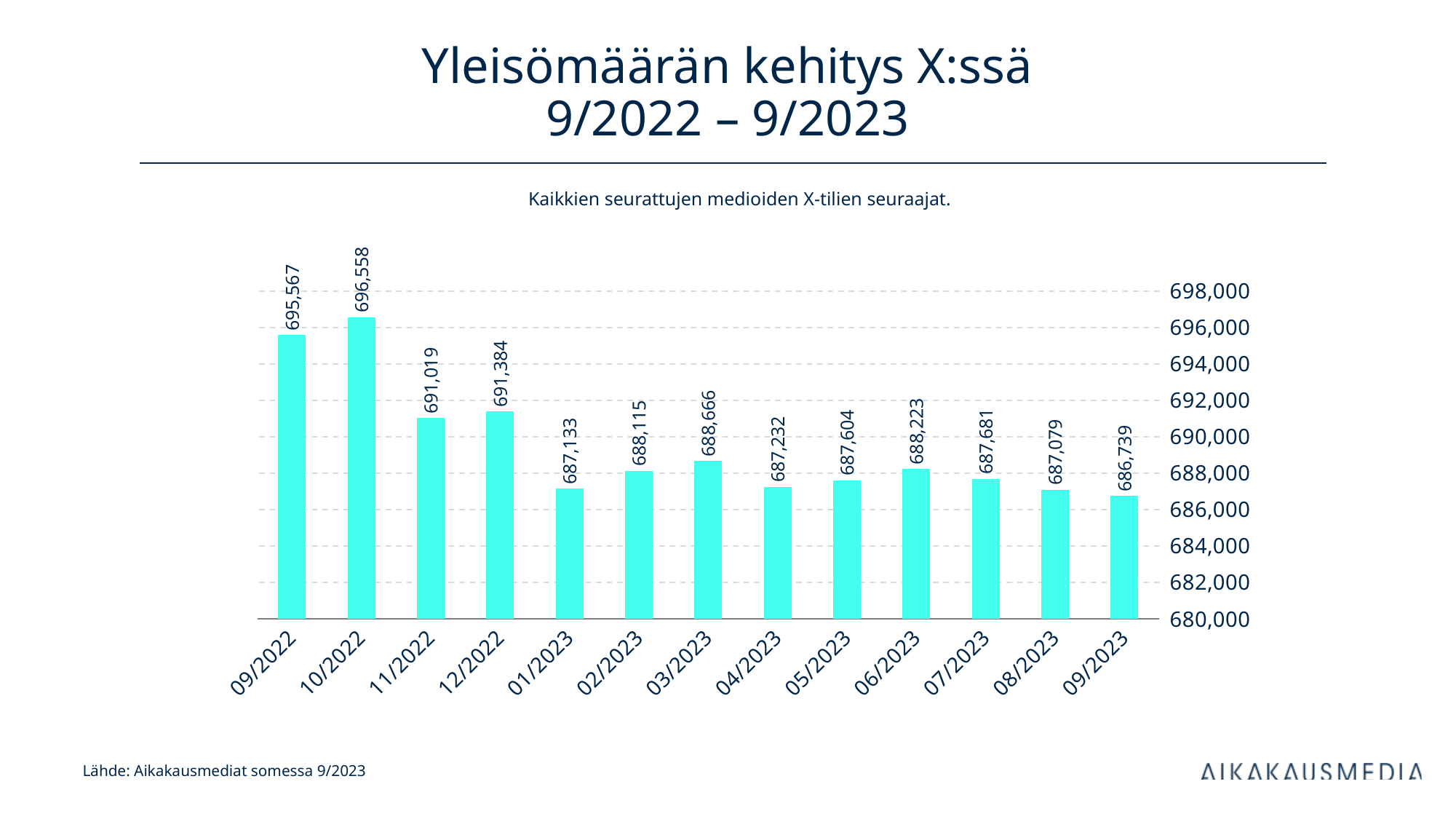
Which month has the highest value? 10/2022 Is the value for 11/2022 greater or less than 690,000? greater What kind of chart is shown on the slide? bar chart What is the value for 09/2023? 686,739 What is the value for 10/2022? 696,558 What is the value for 03/2023? 688,666 Do the values generally rise or fall from 09/2022 to 09/2023? fall What is the difference between the values for 10/2022 and 09/2023? 9,819 How many months are shown on the x axis? 13 Which is larger, the value for 02/2023 or the value for 04/2023? 02/2023 Which month has the lowest value? 09/2023 What is the difference between the values for 12/2022 and 11/2022? 365